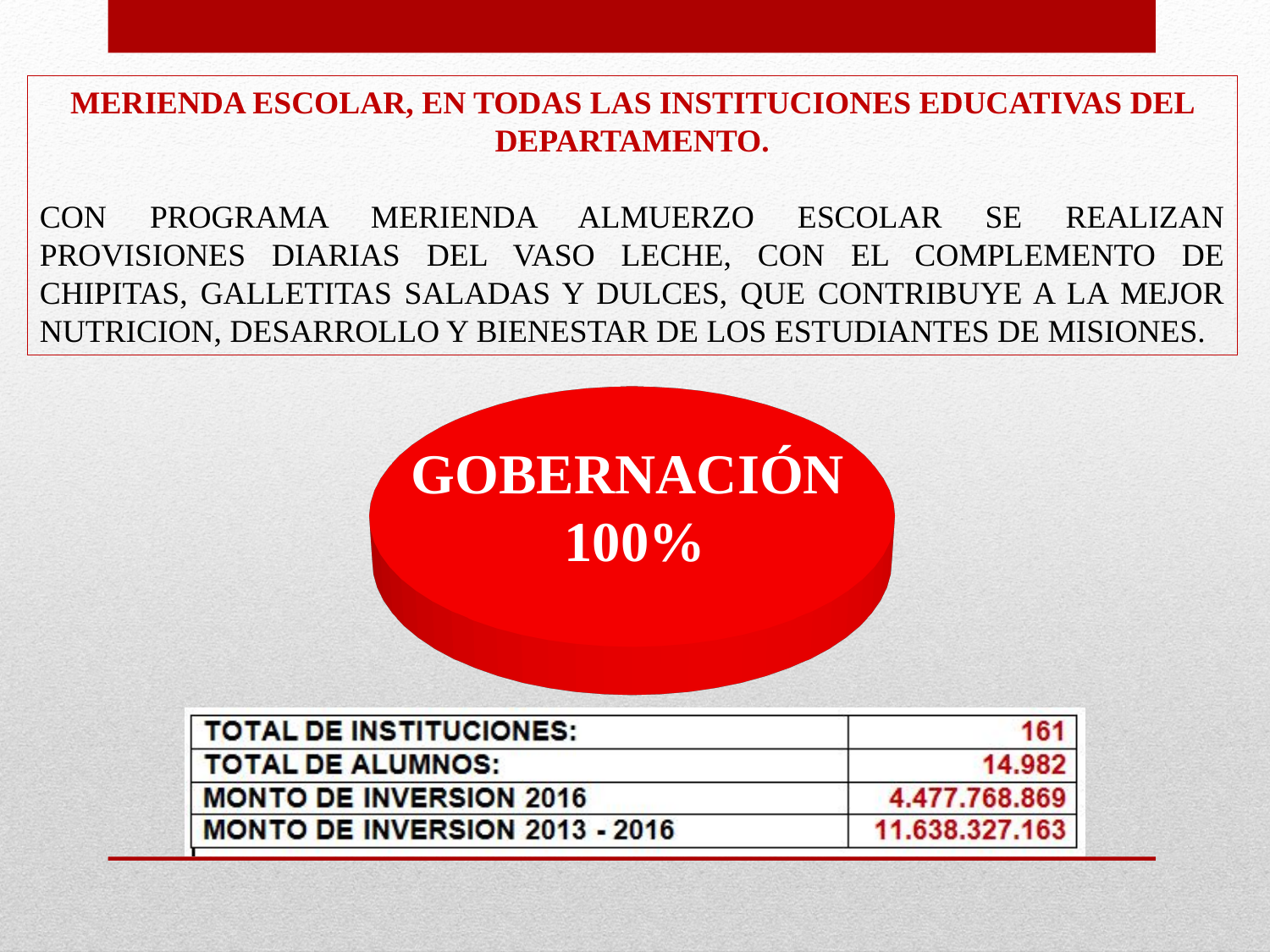
What kind of chart is shown on the slide? pie chart What share of the pie chart does GOBERNACIÓN represent? 100% What colour is the slice of the pie chart? red How many slices does the pie chart have? 1 What is the label printed on the pie chart's slice? GOBERNACIÓN 100% Is the share for GOBERNACIÓN in the pie chart greater or less than 50%? greater Which category is the largest slice of the pie chart? GOBERNACIÓN